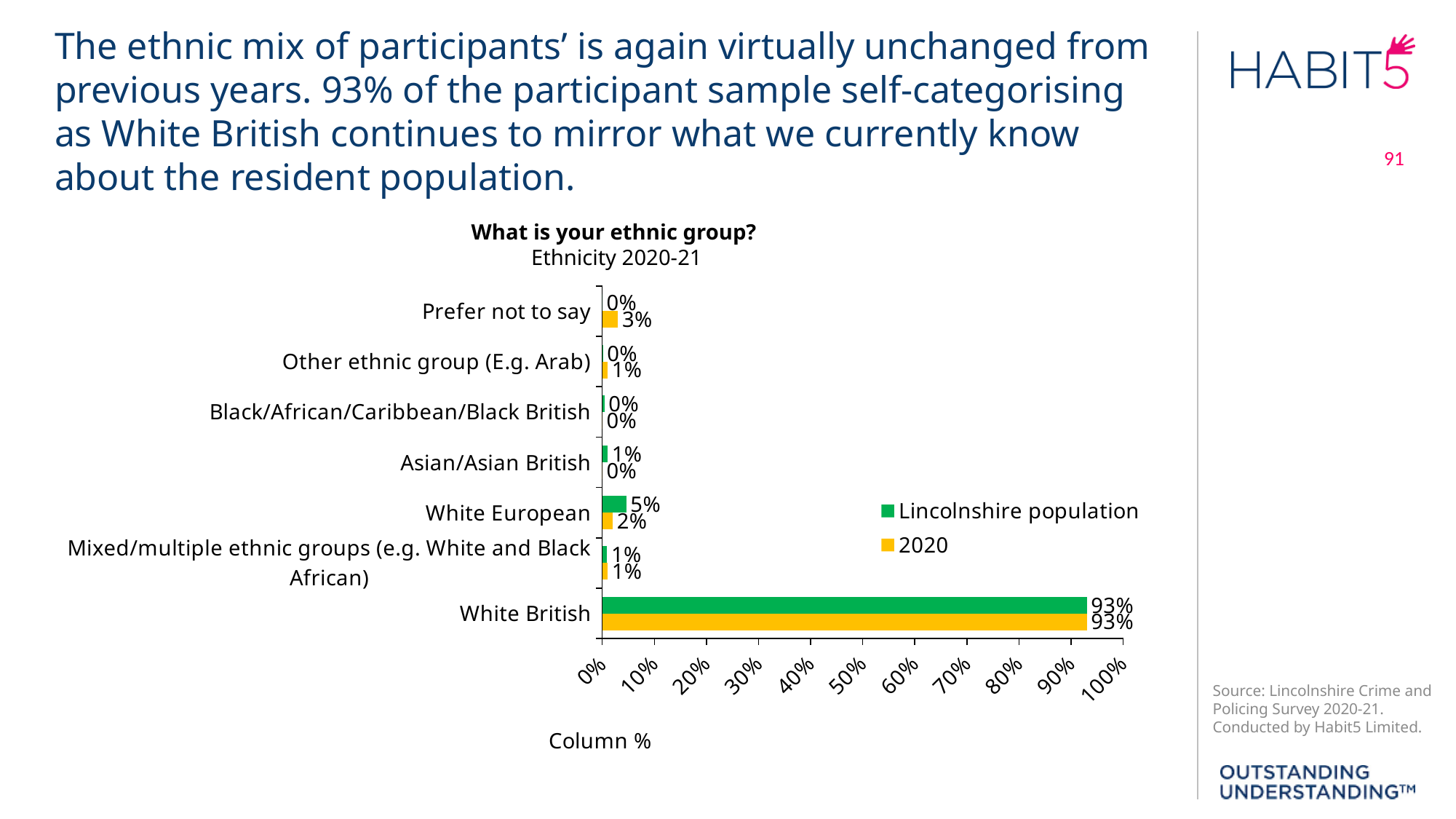
What is the difference between the Lincolnshire population and 2020 values for White European? 3% What is the question shown as the chart's title? What is your ethnic group? How many series does the legend list? 2 What is the Lincolnshire population value for Asian/Asian British? 1% What kind of chart is shown on the slide? Bar chart What is the Lincolnshire population value for White European? 5% What is the 2020 value for White British? 93% For Prefer not to say, which series has the larger value: Lincolnshire population or 2020? 2020 How many ethnic group categories are shown on the chart? 7 What is the 2020 value for Prefer not to say? 3% Which category has the highest 2020 value? White British Is the 2020 value for White British greater or less than 90%? greater